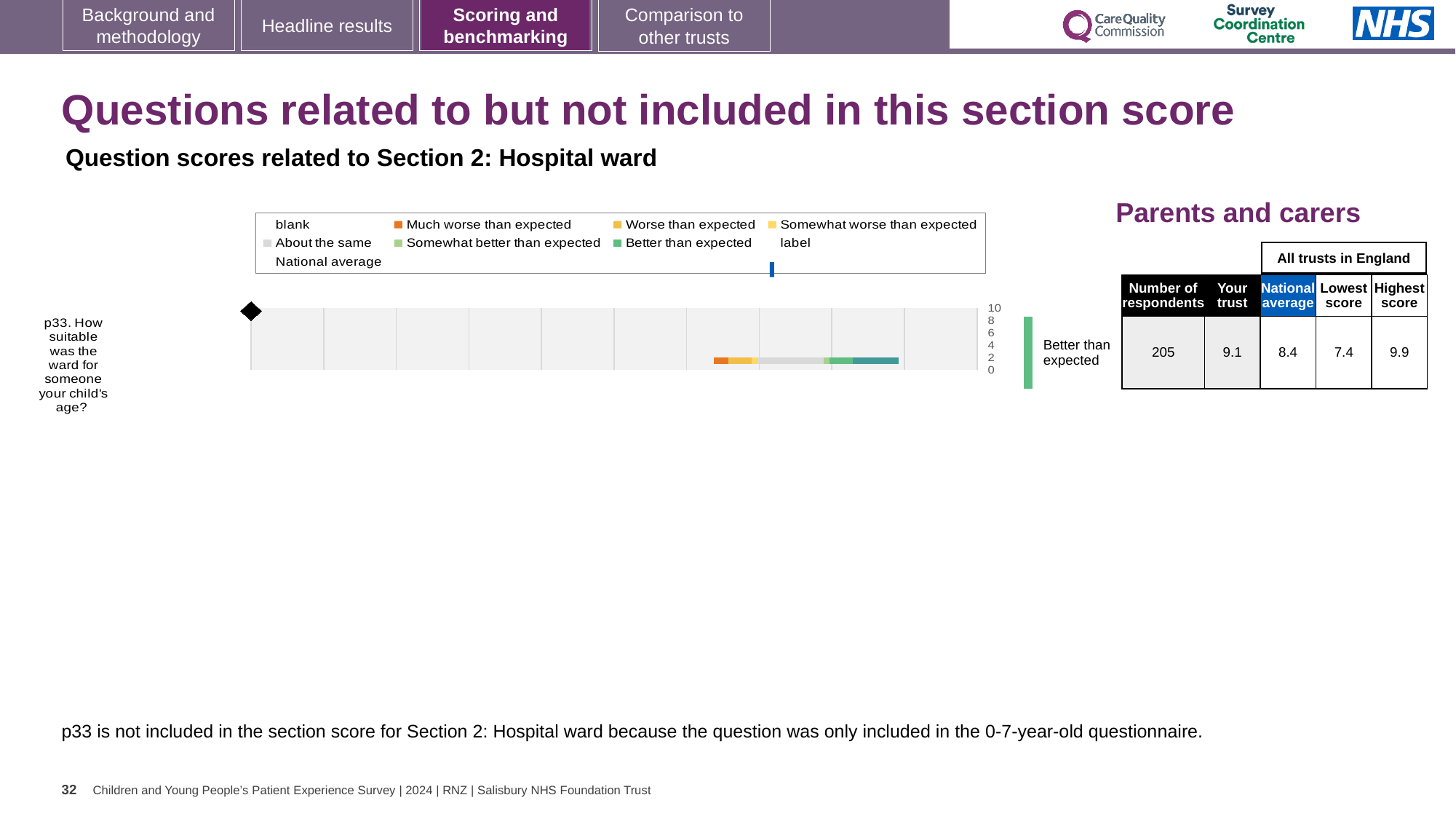
In the table beside the chart, what is the 'Your trust' score for p33? 9.1 What benchmark rating is shown beside the bar for p33? Better than expected How many respondents answered p33? 205 Which question is plotted in the chart? p33. How suitable was the ward for someone your child's age? What is the difference between the 'Your trust' score and the national average for p33? 0.7 What kind of chart is shown for question p33? bar chart In the table beside the chart, what is the highest score among all trusts in England for p33? 9.9 What is the difference between the highest and lowest scores among all trusts in England for p33? 2.5 In the table beside the chart, what is the national average score for p33? 8.4 Which is larger for p33: the 'Your trust' score or the national average? Your trust In the table beside the chart, what is the lowest score among all trusts in England for p33? 7.4 How many questions are plotted in the chart? 1